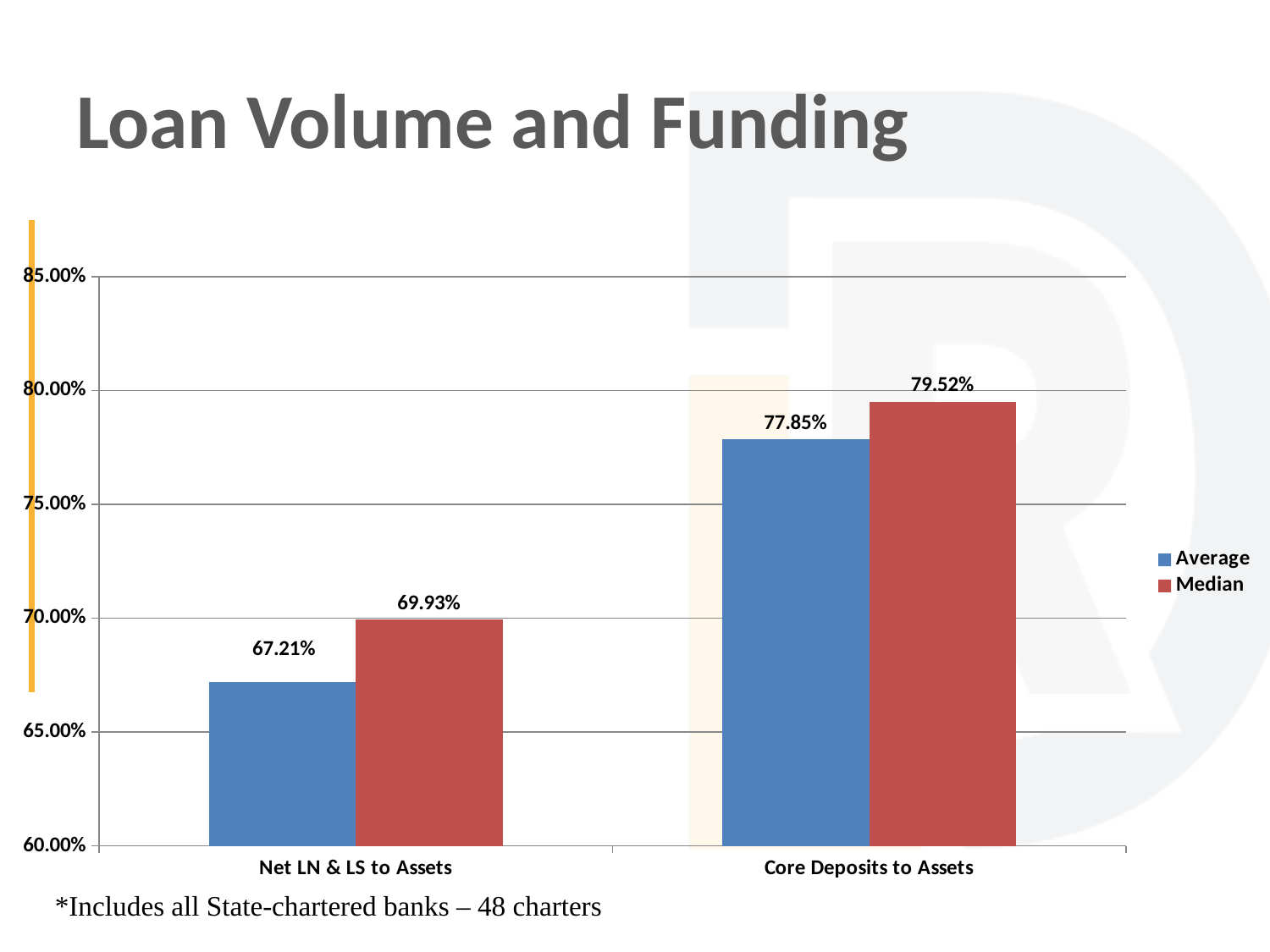
What is the Median value for Net LN & LS to Assets? 69.93% How many series does the legend list? 2 Which category has the highest Median value? Core Deposits to Assets What is the Average value for Net LN & LS to Assets? 67.21% Which colour represents the Median series in the legend? Red What is the Median value for Core Deposits to Assets? 79.52% What is the Average value for Core Deposits to Assets? 77.85% For Net LN & LS to Assets, which is larger, the Average or the Median? Median What kind of chart is shown on the slide? Bar chart Which category has the lowest Average value? Net LN & LS to Assets What is the difference between the Median and Average values for Core Deposits to Assets? 1.67% How many categories are shown on the x axis? 2